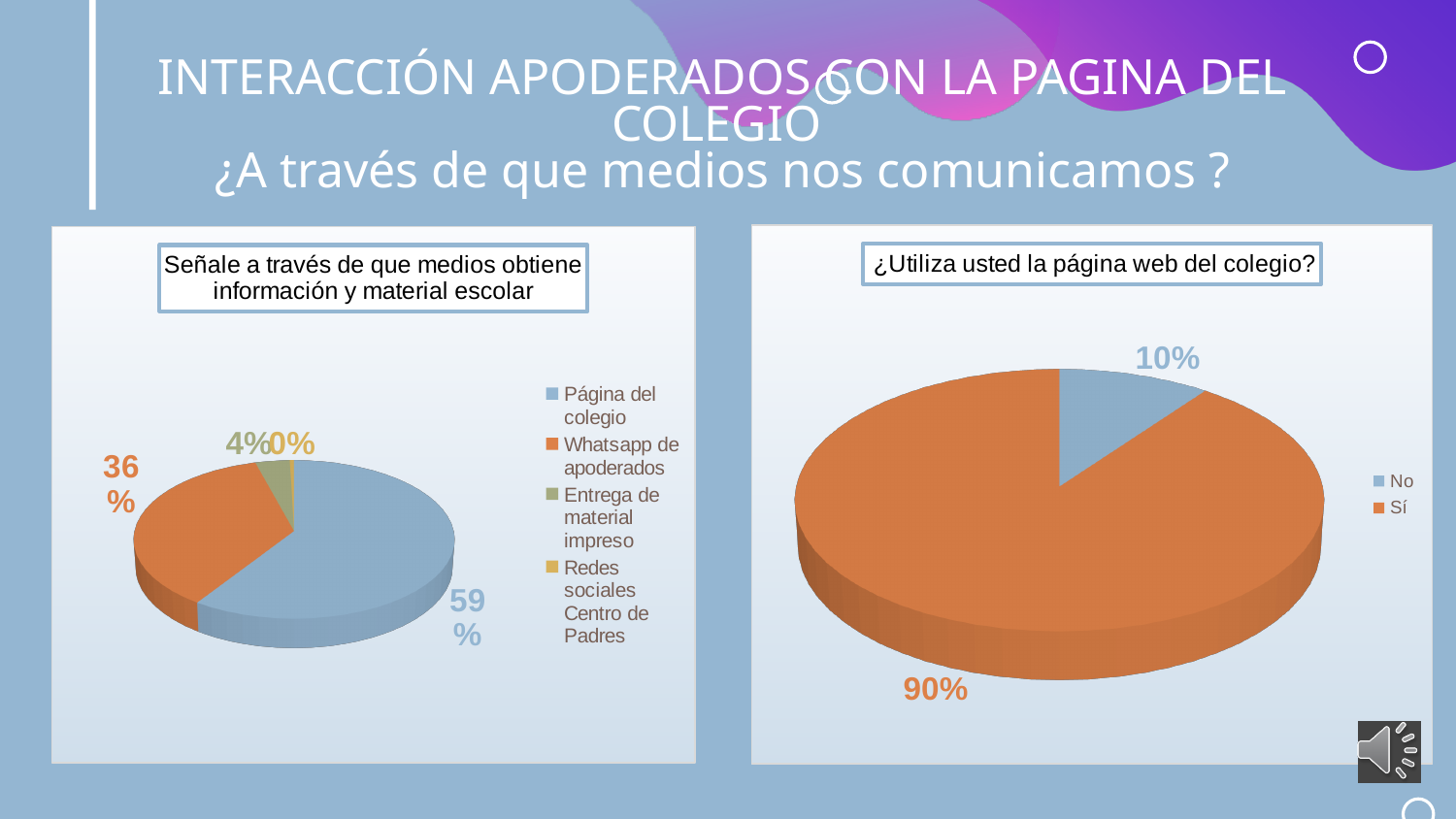
In the left chart, what share of respondents obtain information through the Página del colegio? 59% In the chart titled '¿Utiliza usted la página web del colegio?', what percentage answered No? 10% What type of chart is used on the right side of the slide? Pie chart How many categories does the legend of the left chart list? 4 In the left chart, what percentage corresponds to Whatsapp de apoderados? 36% In the right chart, what colour represents the Sí slice? Orange In the left chart, what is the difference between the shares for Página del colegio and Whatsapp de apoderados? 23% In the left chart, which medium has the largest share? Página del colegio In the chart titled '¿Utiliza usted la página web del colegio?', what percentage answered Sí? 90% In the left chart, which medium has the smallest share? Redes sociales Centro de Padres In the left chart, what percentage corresponds to Entrega de material impreso? 4% In the right chart, which answer is larger, Sí or No? Sí